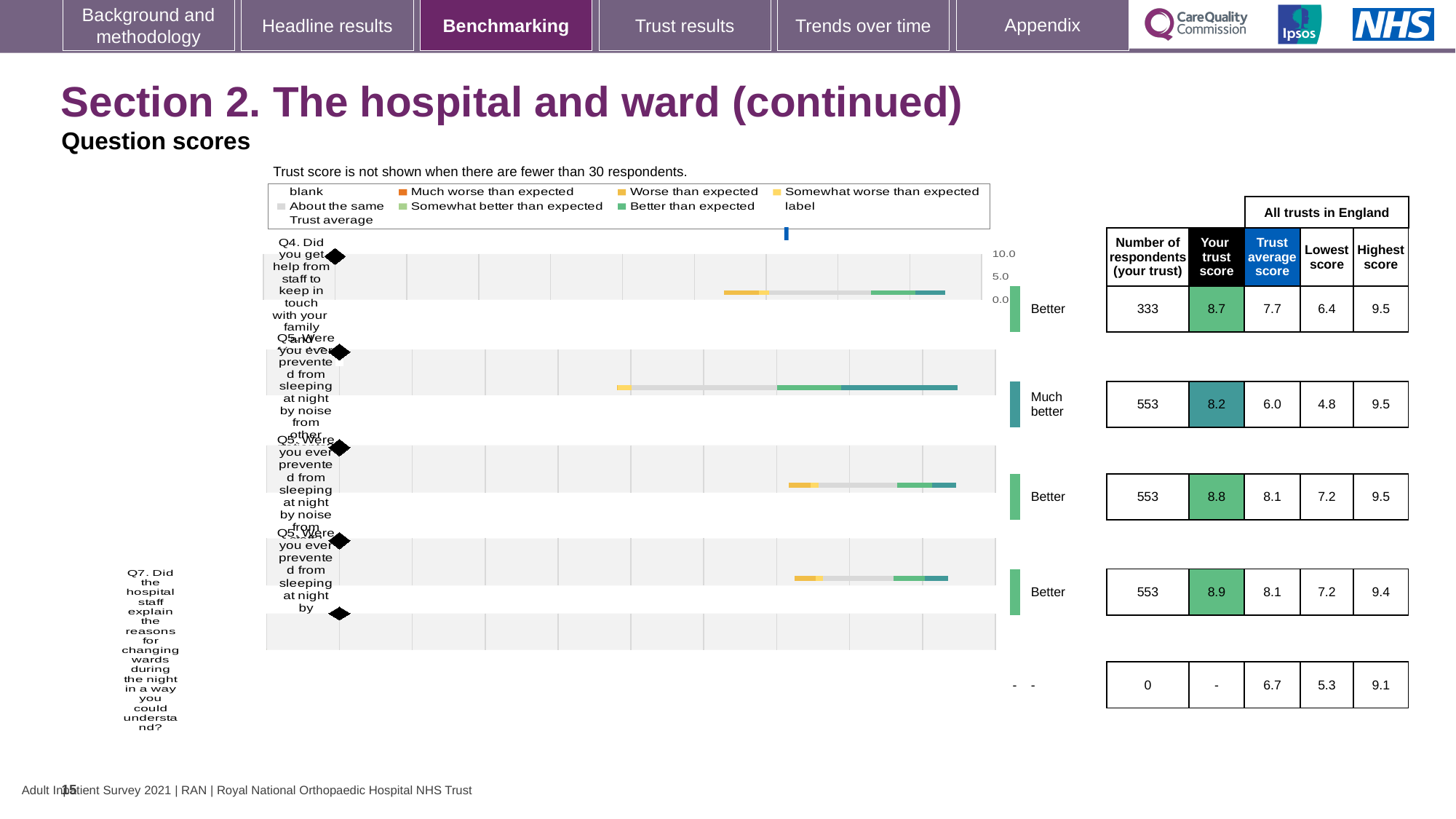
What is the difference between the trust score and the trust average score for Q4 (help from staff to keep in touch with family)? 1.0 What is the 'Your trust score' for the row rated 'Much better' (the second row)? 8.2 What is the trust average score for Q7 (explaining reasons for changing wards during the night)? 6.7 What is the trust average score for Q4 (help from staff to keep in touch with family)? 7.7 How many respondents answered Q4 (help from staff to keep in touch with family) at this trust? 333 What is the 'Your trust score' for Q4 (help from staff to keep in touch with family)? 8.7 What is the maximum value shown on the score axis of the chart? 10.0 Which row has the highest 'Your trust score' in the table? the fourth row (8.9) What is the lowest score across all trusts in England for the row rated 'Much better' (the second row)? 4.8 What kind of chart is used to show the question scores on this slide? bar chart Which legend entry is shown in dark orange? Much worse than expected How many respondents answered Q7 (explaining reasons for changing wards during the night) at this trust? 0